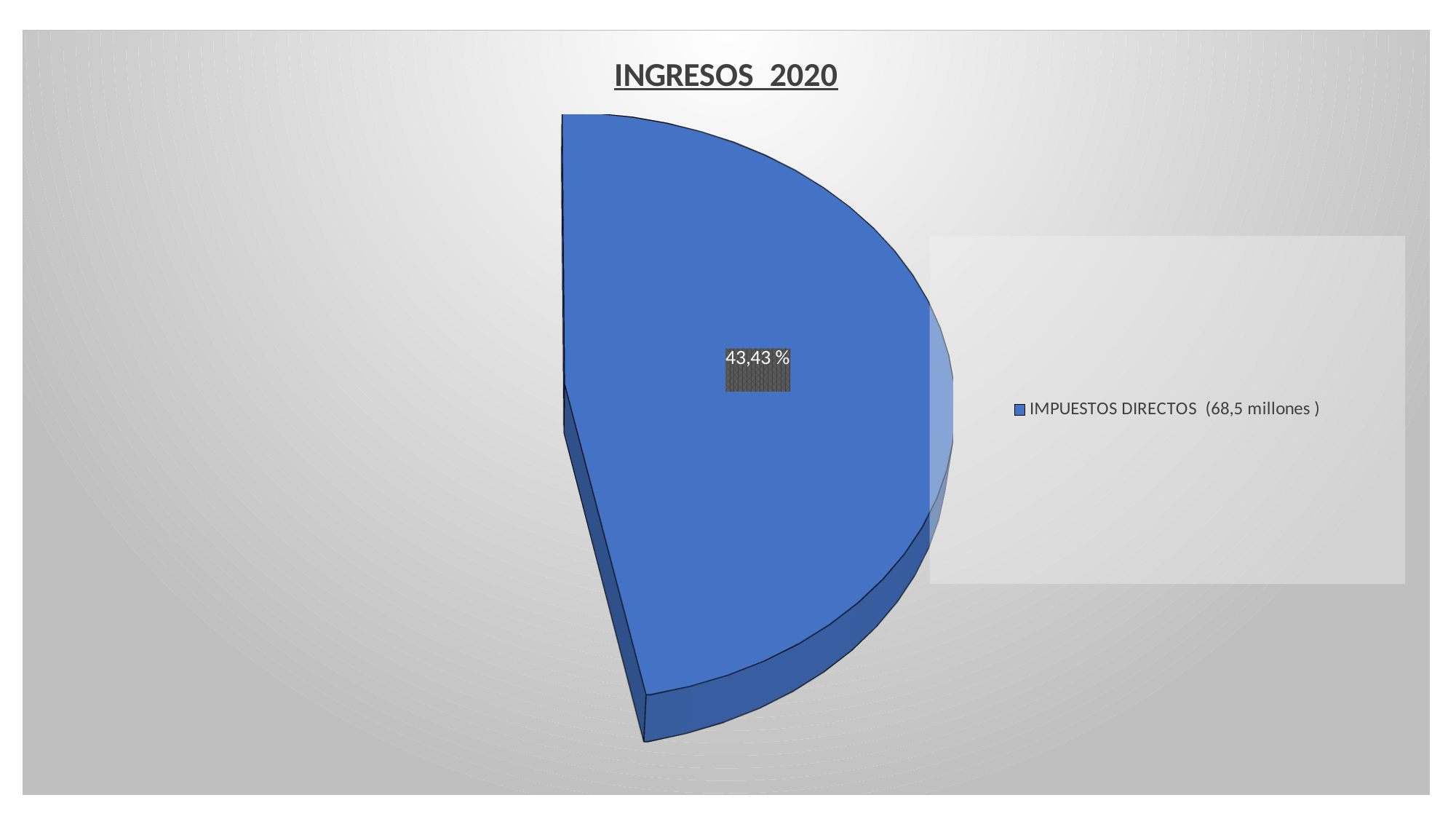
What kind of chart is shown on the slide? pie chart Is the share of the IMPUESTOS DIRECTOS slice greater or less than 50%? less What share of the pie does the IMPUESTOS DIRECTOS slice represent? 43,43 % What is the title of the chart? INGRESOS 2020 What amount in millions is given in the legend for IMPUESTOS DIRECTOS? 68,5 millones What category does the legend entry name? IMPUESTOS DIRECTOS (68,5 millones ) How many entries does the legend list? 1 What percentage is printed on the visible slice of the pie? 43,43 %